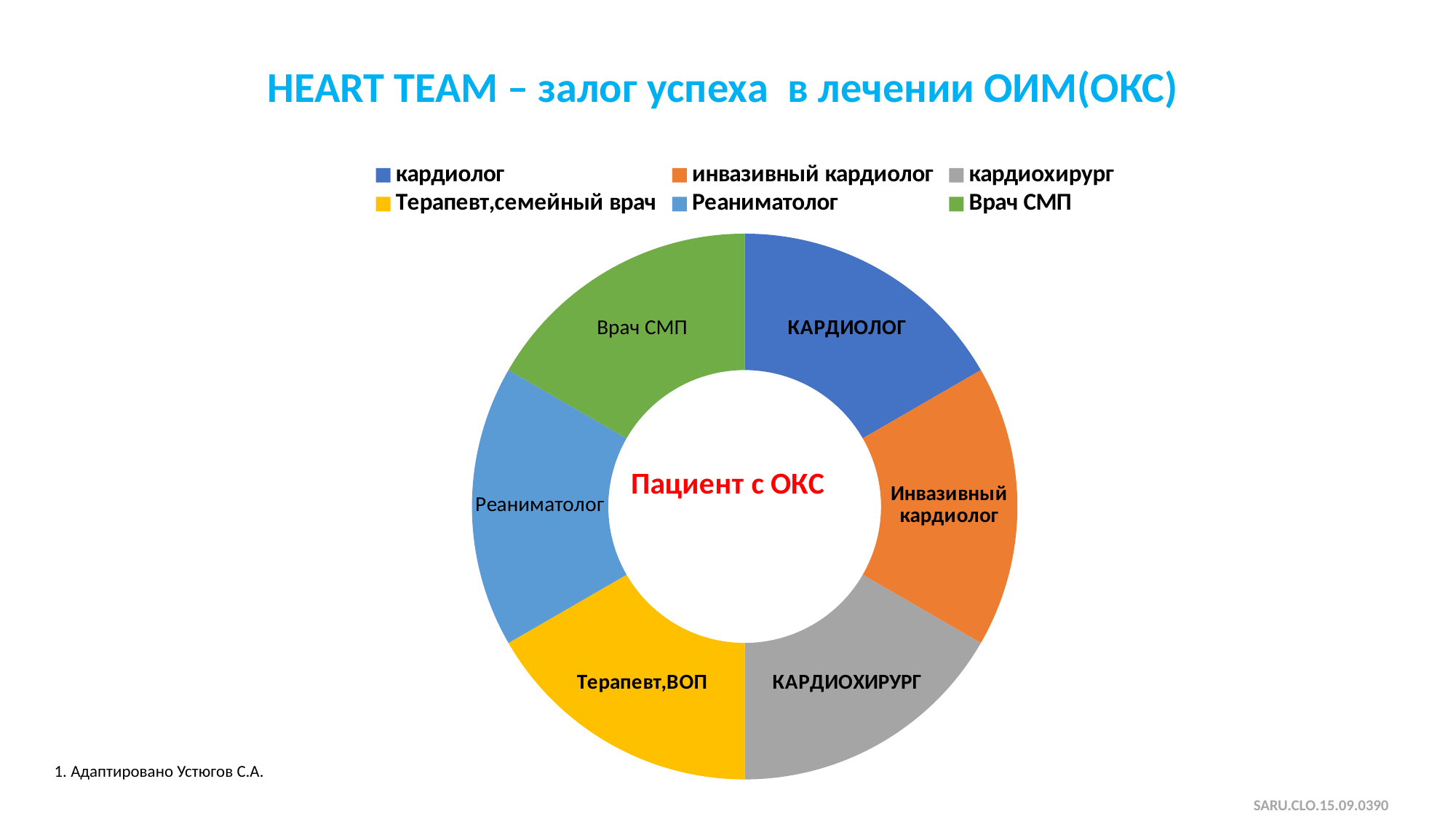
Which colour represents the segment labelled 'Врач СМП'? Green Which segment of the chart is coloured light blue? Реаниматолог Which segment of the chart is coloured grey? КАРДИОХИРУРГ Which segment of the chart is coloured yellow? Терапевт,ВОП What kind of chart is shown on the slide? Doughnut chart How many segments does the doughnut chart have? 6 What text is written in the centre of the doughnut chart? Пациент с ОКС How many entries does the chart legend list? 6 Which segment of the chart is coloured dark blue? КАРДИОЛОГ Which segment of the chart is coloured orange? Инвазивный кардиолог